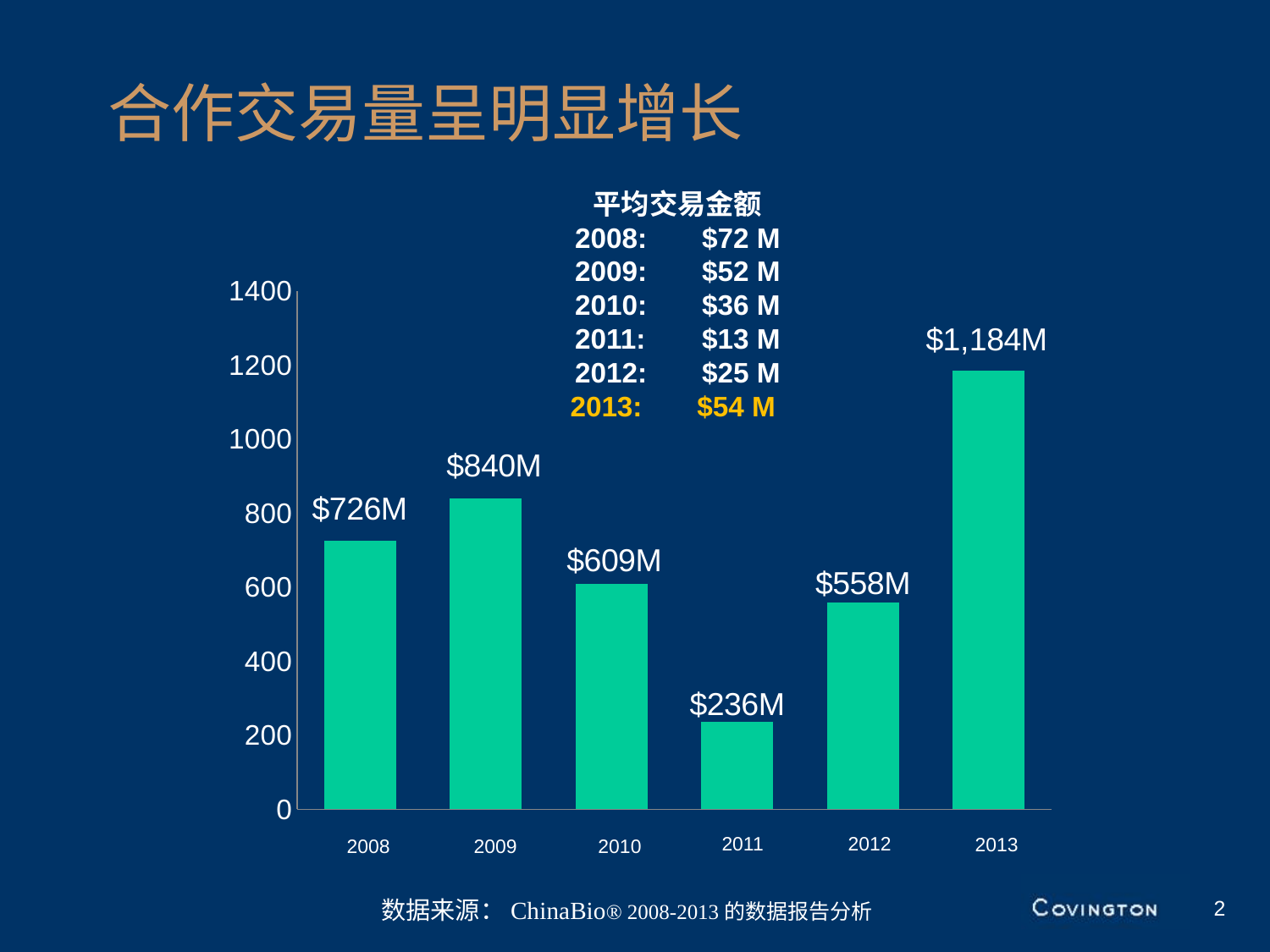
What is the difference between the values for 2013 and 2012? $626M Is the value for 2010 greater or less than 400? greater Which year has the lowest value? 2011 What is the value for 2013? $1,184M Which year has the highest value? 2013 Does the value rise or fall from 2011 to 2013? rise What is the value for 2008? $726M What kind of chart is shown on the slide? bar chart Which is larger, the value for 2008 or the value for 2012? 2008 What is the value for 2011? $236M What is the difference between the values for 2009 and 2010? $231M How many years are shown on the x axis? 6